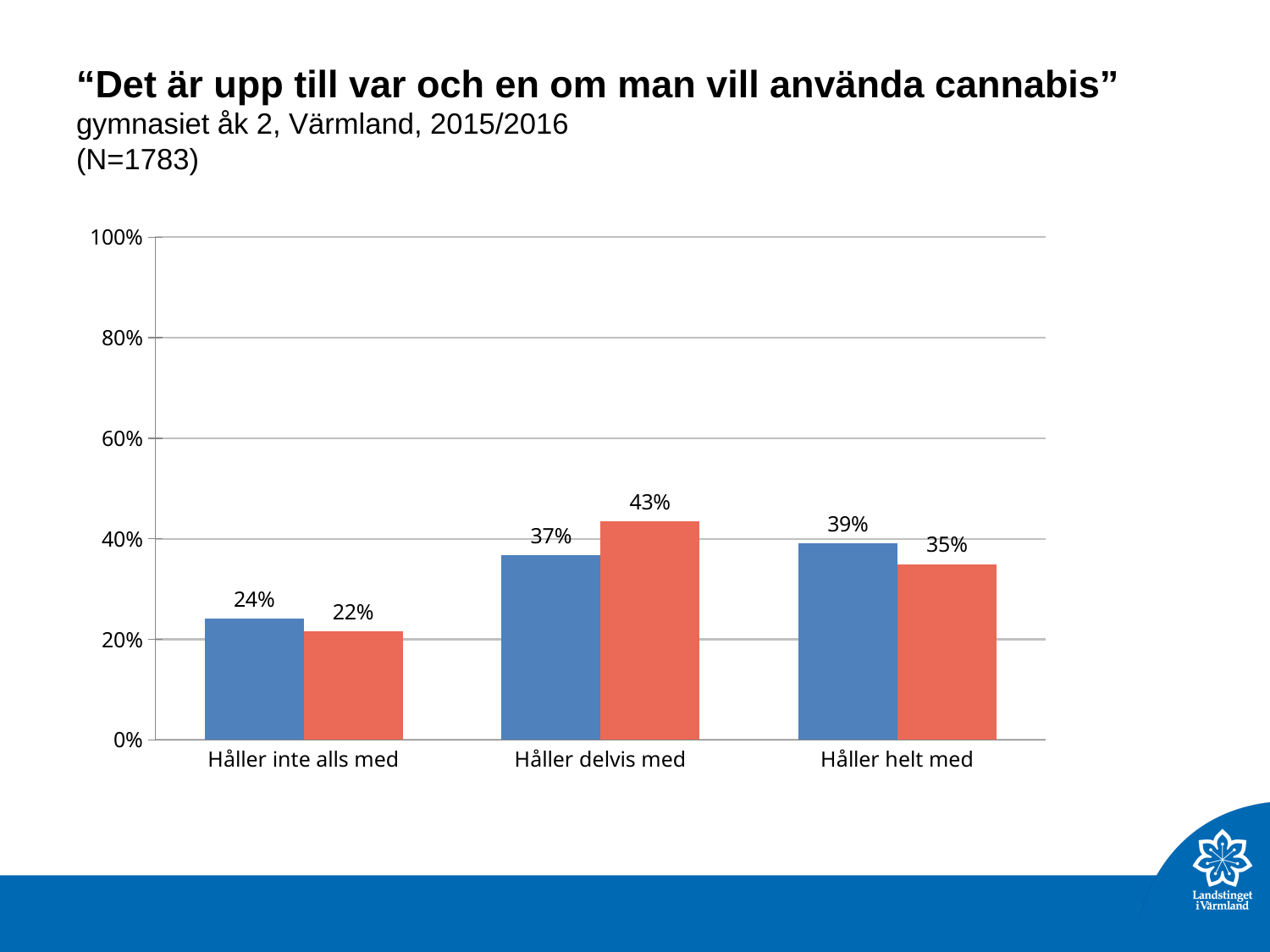
Is the red bar for "Håller delvis med" greater or less than 40%? greater What is the value of the blue bar for "Håller delvis med"? 37% What is the difference between the red and blue bars for "Håller delvis med"? 6% How many categories are shown on the x axis? 3 What is the value of the red bar for "Håller inte alls med"? 22% What is the value of the red bar for "Håller helt med"? 35% What kind of chart is shown on the slide? bar chart Which category has the lowest red bar? Håller inte alls med For "Håller helt med", which bar is larger, the blue or the red? blue Which category has the highest blue bar? Håller helt med What is the sample size (N) stated in the chart title? 1783 What is the difference between the blue bars for "Håller helt med" and "Håller inte alls med"? 15%